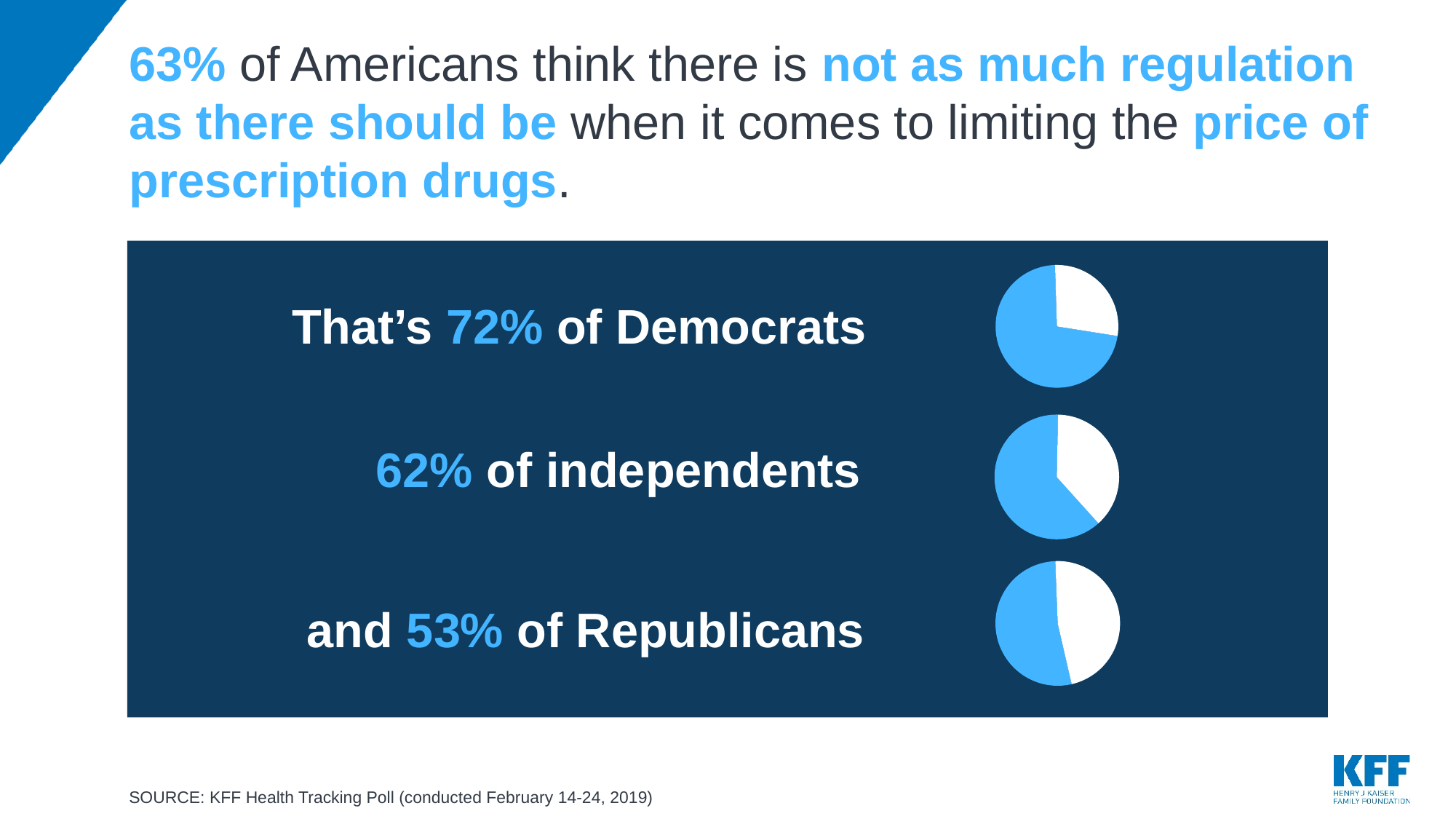
Which group has the highest share shown across the three pie charts? Democrats What share of Democrats think there is not as much regulation as there should be on prescription drug prices, as shown by the top pie chart? 72% Which is larger: the share of independents or the share of Republicans? independents What kind of charts are shown on the right side of the dark panel? pie charts What is the difference between the share of Democrats and the share of Republicans shown in the pie charts? 19 percentage points What share of Republicans is shown by the bottom pie chart? 53% How many pie charts are on the slide? 3 What share of all Americans is stated in the slide title? 63% Which group has the lowest share shown across the three pie charts? Republicans What is the difference between the share of Democrats and the share of independents shown in the pie charts? 10 percentage points What colour is used for the highlighted slice in each pie chart? light blue What share of independents is shown by the middle pie chart? 62%